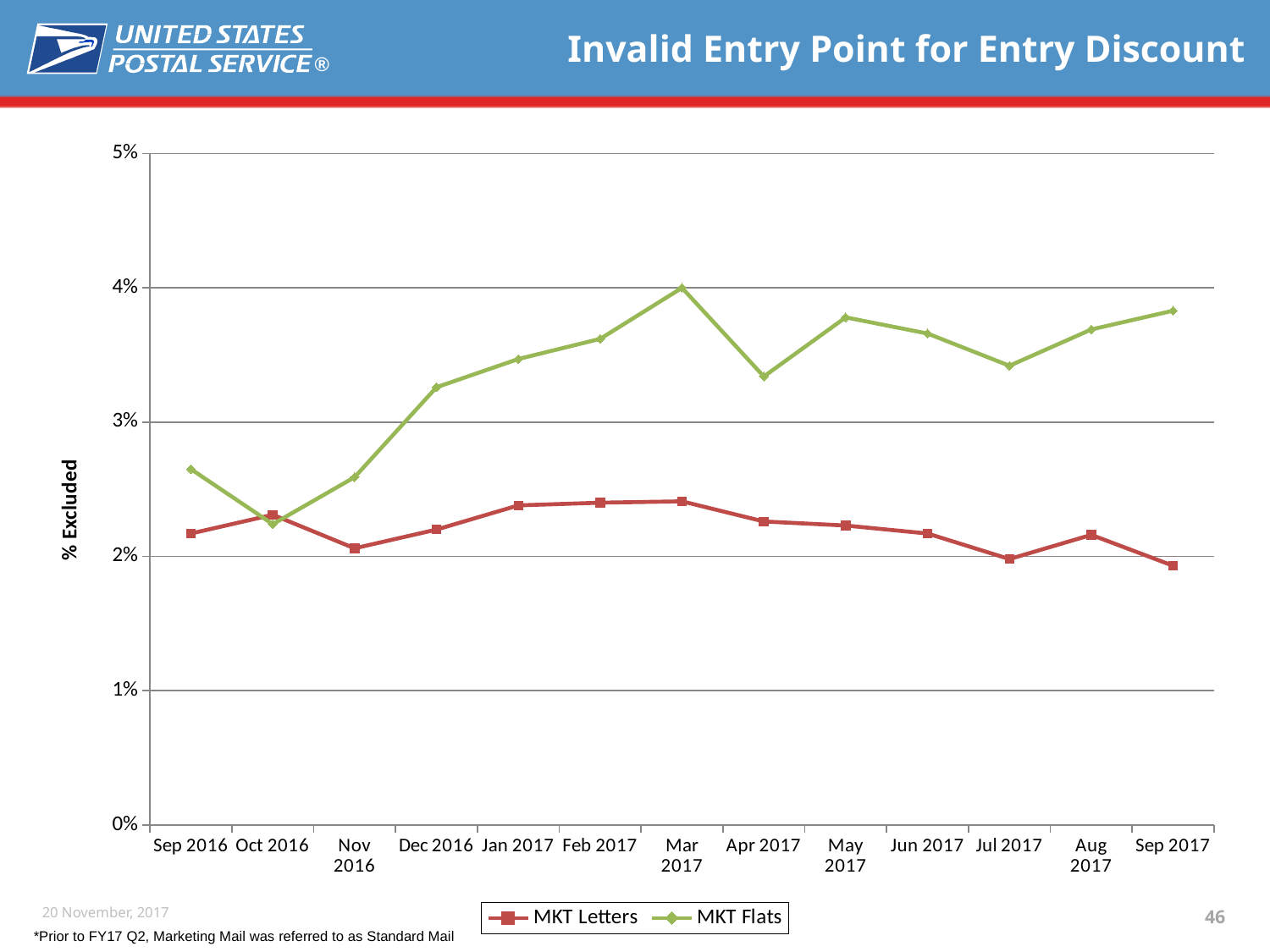
What is the label on the y axis of the chart? % Excluded Which series has the larger value in Sep 2016, MKT Letters or MKT Flats? MKT Flats In which month does the MKT Flats series reach its lowest value? Oct 2016 Is the value for MKT Flats in Sep 2016 greater or less than 3%? less Which series has the larger value in Mar 2017, MKT Letters or MKT Flats? MKT Flats How many series does the legend list? 2 What kind of chart is shown on the slide? Line chart Is the value for MKT Letters in Jan 2017 greater or less than 2%? greater How many months are plotted along the x axis? 13 In which month does the MKT Flats series reach its highest value? Mar 2017 Is the value for MKT Flats in Dec 2016 greater or less than 3%? greater Does the MKT Flats series generally rise or fall from Oct 2016 to Mar 2017? Rise